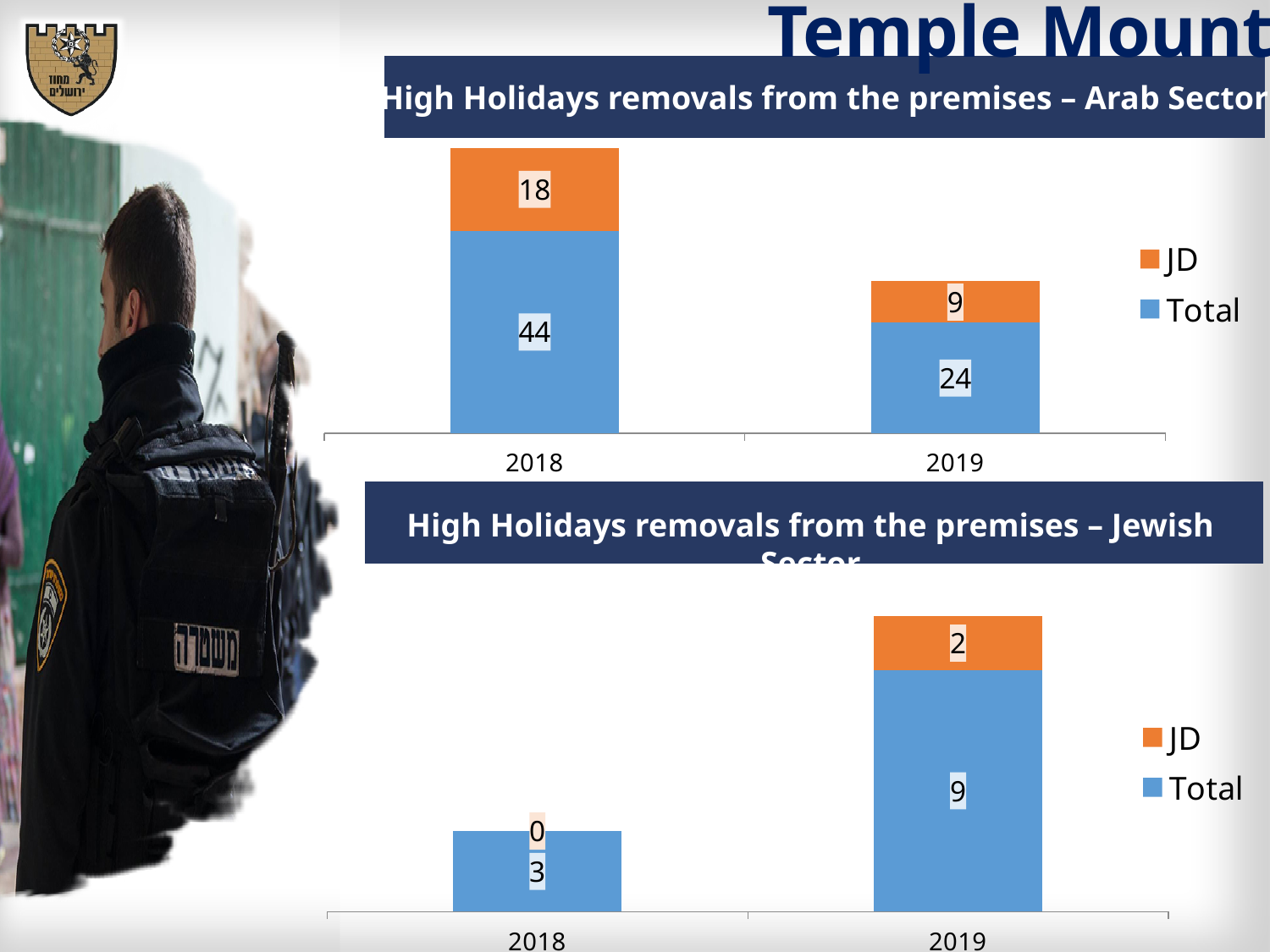
In the 'High Holidays removals from the premises – Jewish Sector' chart, what is the Total value for 2019? 9 How many series does the legend of the 'High Holidays removals from the premises – Arab Sector' chart list? 2 What kind of chart is the 'High Holidays removals from the premises – Jewish Sector' chart? stacked bar chart In the 'High Holidays removals from the premises – Arab Sector' chart, what is the JD value for 2019? 9 In the 'High Holidays removals from the premises – Arab Sector' chart, what is the combined height of the stacked bar for 2018? 62 In the 'High Holidays removals from the premises – Jewish Sector' chart, do the Total values rise or fall from 2018 to 2019? rise In the 'High Holidays removals from the premises – Arab Sector' chart, what is the Total value for 2018? 44 In the 'High Holidays removals from the premises – Jewish Sector' chart, what is the combined height of the stacked bar for 2019? 11 In the 'High Holidays removals from the premises – Jewish Sector' chart, what is the JD value for 2018? 0 In the 'High Holidays removals from the premises – Arab Sector' chart, which year has the higher JD value? 2018 In the 'High Holidays removals from the premises – Arab Sector' chart, what is the difference between the Total values for 2018 and 2019? 20 In the 'High Holidays removals from the premises – Jewish Sector' chart, which year has the lower Total value? 2018